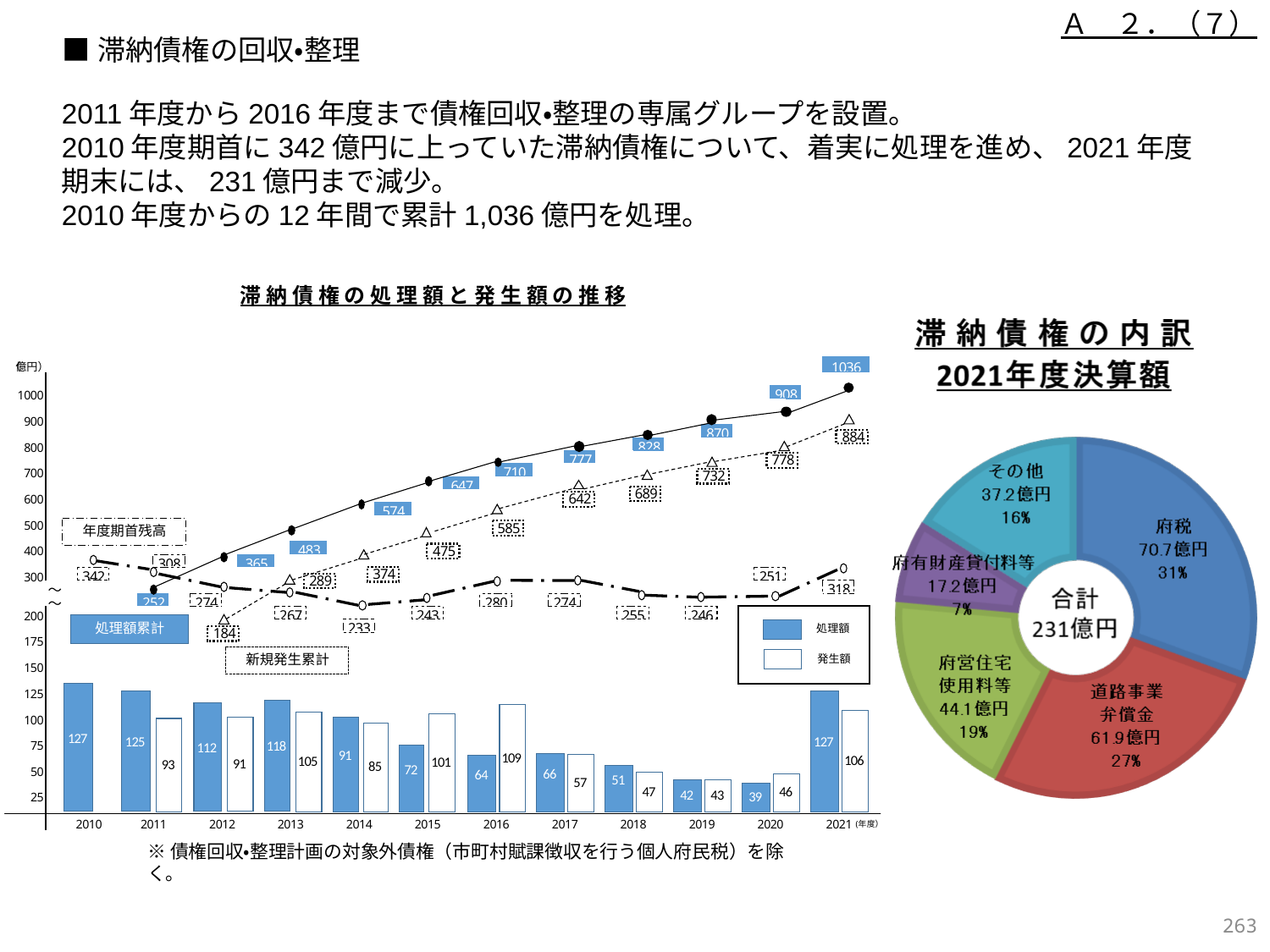
In the chart titled 滞納債権の処理額と発生額の推移, what is the 処理額累計 value for 2021? 1036 In the chart titled 滞納債権の内訳 2021年度決算額, how many slices does the pie have? 5 In the chart titled 滞納債権の処理額と発生額の推移, what is the 処理額 value for 2020? 39 In the chart titled 滞納債権の処理額と発生額の推移, how many series does the legend list? 2 In the chart titled 滞納債権の処理額と発生額の推移, which year has the lowest 処理額 bar? 2020 In the chart titled 滞納債権の内訳 2021年度決算額, what kind of chart is it? pie chart In the chart titled 滞納債権の処理額と発生額の推移, which is larger for 2017, the 処理額 bar or the 発生額 bar? 処理額 In the chart titled 滞納債権の処理額と発生額の推移, what is the difference between the 処理額 and 発生額 bars for 2021? 21 In the chart titled 滞納債権の内訳 2021年度決算額, which category has the largest share? 府税 In the chart titled 滞納債権の内訳 2021年度決算額, what share of the total is 府営住宅使用料等? 19% In the chart titled 滞納債権の処理額と発生額の推移, what is the 発生額 value for 2016? 109 In the chart titled 滞納債権の処理額と発生額の推移, does the 処理額累計 line rise or fall from 2011 to 2021? rise